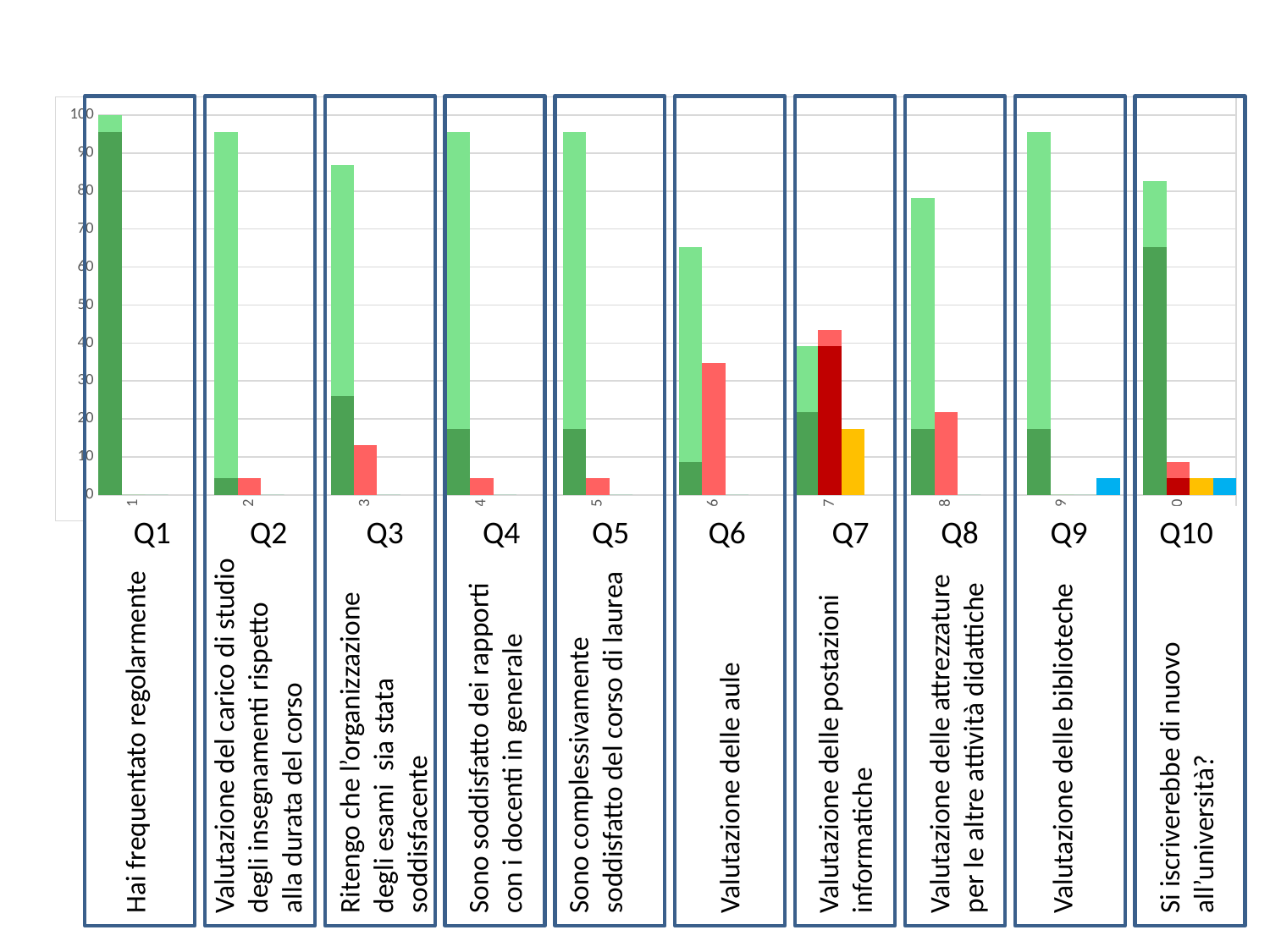
Is the light red bar for Q7 greater or less than 50? less Is the dark green bar for Q10 greater or less than 60? greater What is the text label shown under Q10? Si iscriverebbe di nuovo all'università? What kind of chart is shown on the slide? bar chart How many question categories (Q1 to Q10) are plotted on the chart? 10 Which question has the tallest dark green bar? Q1 Is the orange bar for Q7 greater or less than 20? less Which has the taller light green bar, Q6 or Q8? Q8